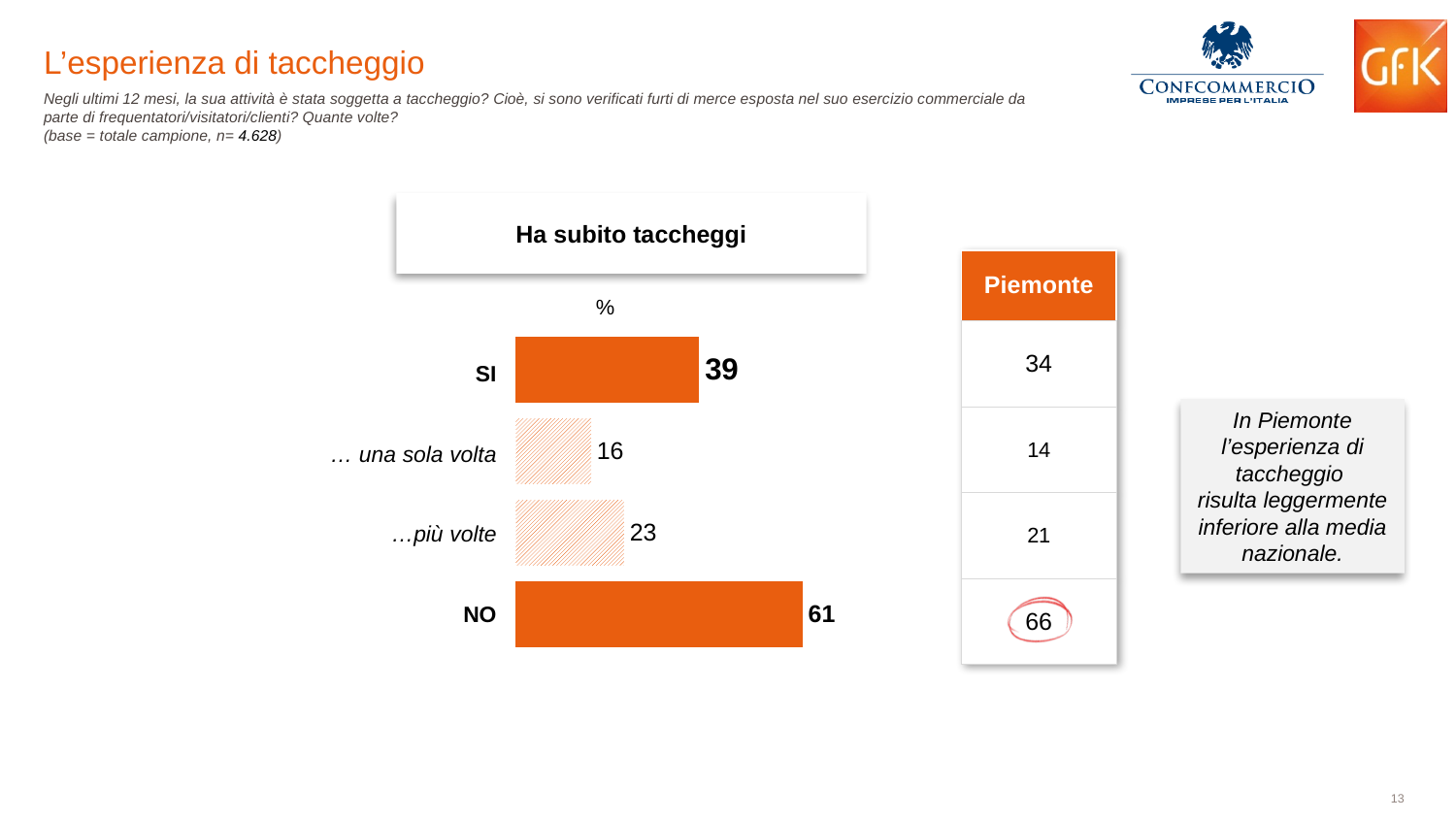
What is the value for '… una sola volta' in the 'Ha subito taccheggi' chart? 16 What is the value for SI in the 'Ha subito taccheggi' chart? 39 What is the title of the chart on the slide? Ha subito taccheggi What is the difference between the NO and SI values in the 'Ha subito taccheggi' chart? 22 What is the value for '…più volte' in the 'Ha subito taccheggi' chart? 23 What type of chart is 'Ha subito taccheggi'? Bar chart Which category has the highest value in the 'Ha subito taccheggi' chart? NO Which is larger in the 'Ha subito taccheggi' chart: '… una sola volta' or '…più volte'? …più volte Which category has the lowest value in the 'Ha subito taccheggi' chart? … una sola volta What unit is indicated above the bars in the 'Ha subito taccheggi' chart? % How many categories are shown in the 'Ha subito taccheggi' chart? 4 What is the value for NO in the 'Ha subito taccheggi' chart? 61